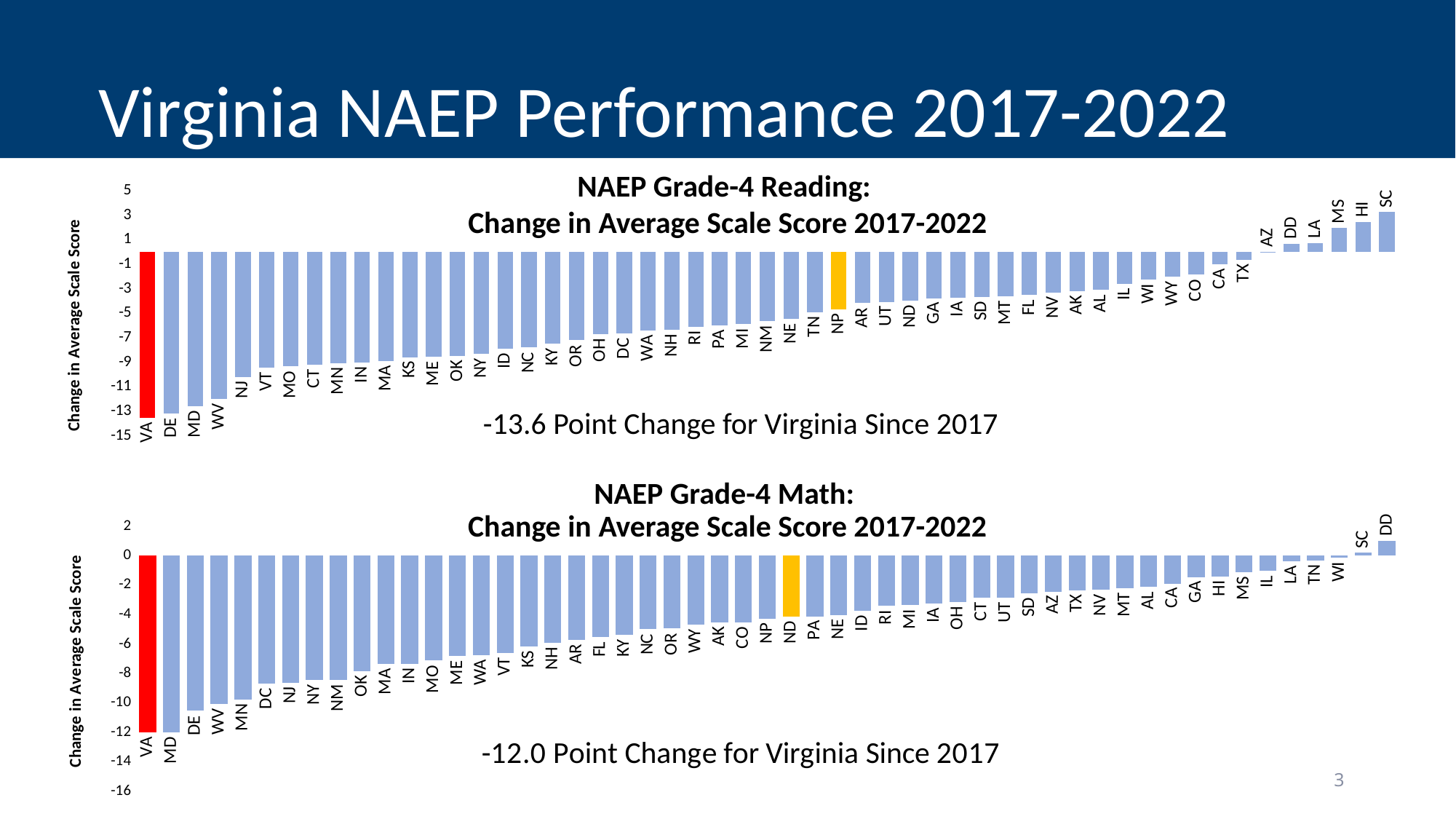
In the NAEP Grade-4 Reading chart, what colour is the bar for VA? Red What is the difference between Virginia's reading change (-13.6) and its math change (-12.0) shown on the slide? 1.6 In the NAEP Grade-4 Math chart, which category has the highest change in average scale score? DD What type of chart is the NAEP Grade-4 Math chart? Bar chart In the NAEP Grade-4 Reading chart, what is the point change for Virginia since 2017? -13.6 In the NAEP Grade-4 Reading chart, which category has the highest change in average scale score? SC In the NAEP Grade-4 Math chart, what is the point change for Virginia since 2017? -12.0 In the NAEP Grade-4 Math chart, is the value for OK greater or less than -6? less In the NAEP Grade-4 Reading chart, is the value for DE greater or less than -11? less In the NAEP Grade-4 Reading chart, which state has the lowest change in average scale score? VA In the NAEP Grade-4 Math chart, which has the larger (less negative) change, MD or DE? DE